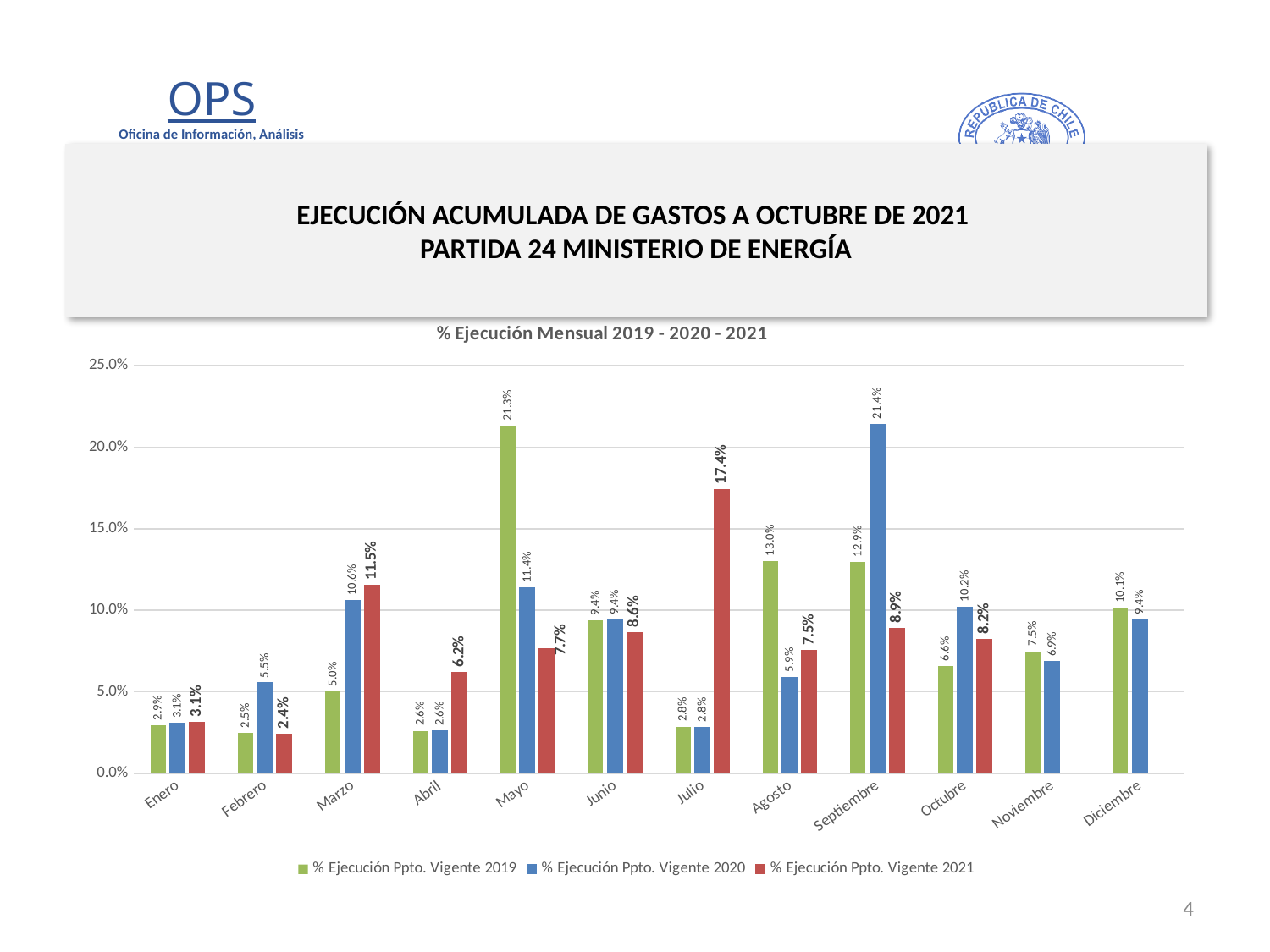
What is the value for % Ejecución Ppto. Vigente 2019 in Mayo? 21.3% What is the value for % Ejecución Ppto. Vigente 2021 in Julio? 17.4% How many months are shown on the x axis? 12 How many series does the legend list? 3 Is the value for % Ejecución Ppto. Vigente 2020 in Septiembre greater or less than 20.0%? greater What kind of chart is shown on the slide? Bar chart Which month has the lowest value for % Ejecución Ppto. Vigente 2021? Febrero What is the title of the chart? % Ejecución Mensual 2019 - 2020 - 2021 What is the difference between the 2021 and 2019 values in Marzo? 6.5% In Agosto, which is larger: the 2019 value or the 2020 value? 2019 What is the value for % Ejecución Ppto. Vigente 2020 in Octubre? 10.2% Which month has the highest value for % Ejecución Ppto. Vigente 2020? Septiembre